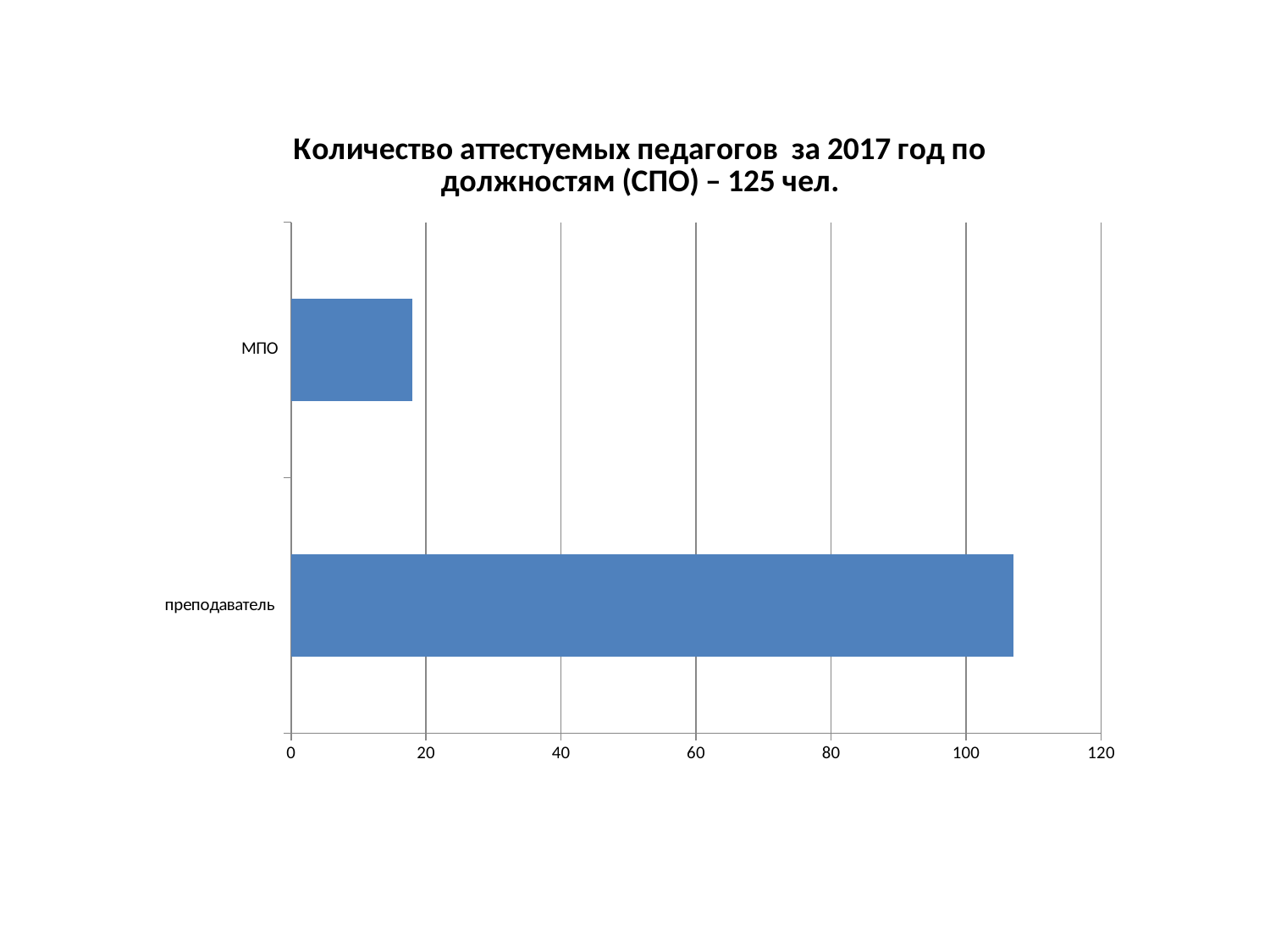
How many categories are plotted in the chart? 2 Is the value for МПО greater or less than 40? less Which is larger, the value for МПО or the value for преподаватель? преподаватель What kind of chart is shown on the slide? bar chart Which category has the lowest value? МПО Is the value for преподаватель greater or less than 120? less Which category has the highest value? преподаватель What is the title of the chart? Количество аттестуемых педагогов за 2017 год по должностям (СПО) – 125 чел. What is the maximum value shown on the horizontal axis? 120 Is the value for преподаватель greater or less than 100? greater